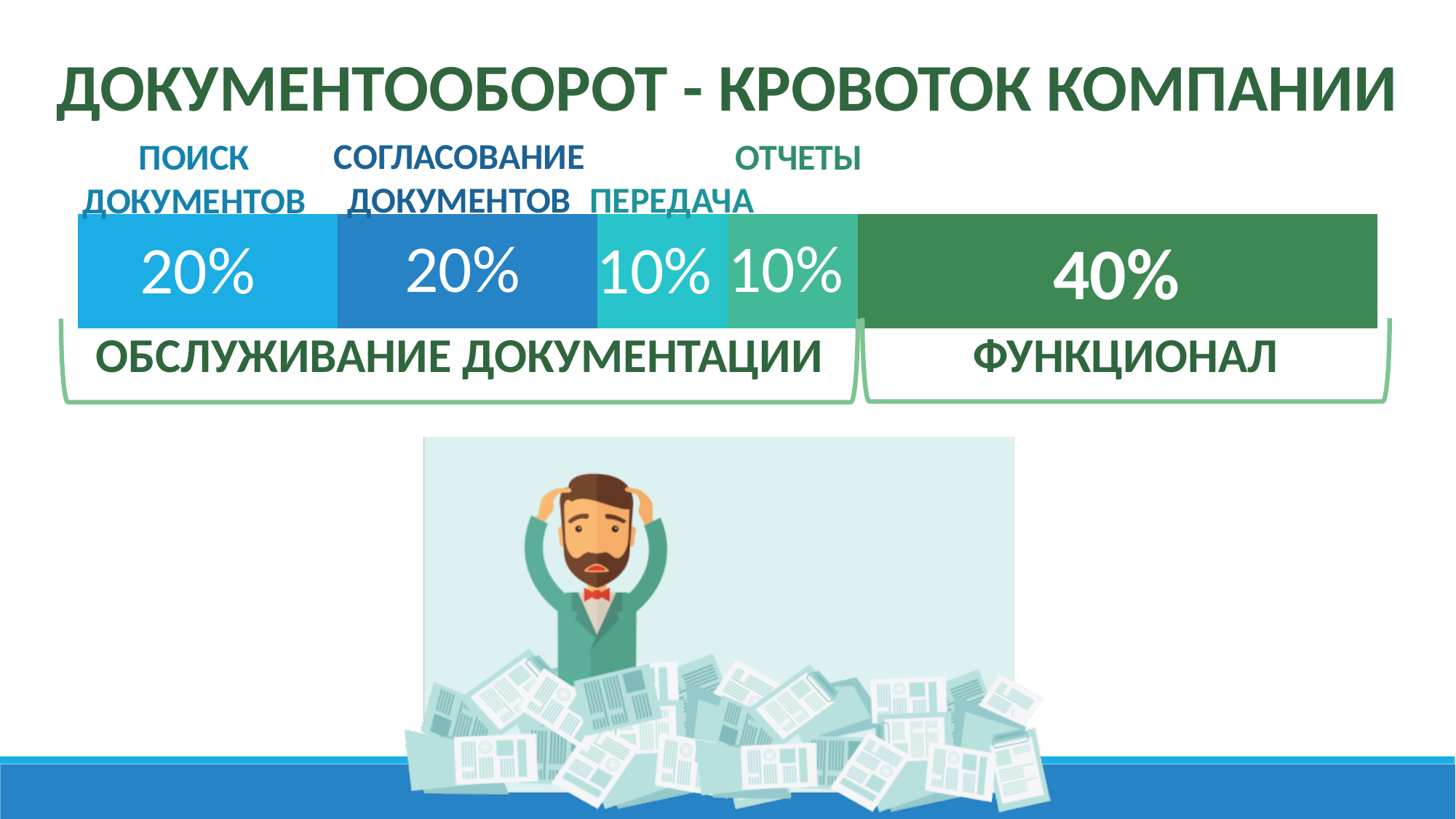
What percentage is shown for the segment labelled ПЕРЕДАЧА? 10% What percentage is shown for the segment labelled ФУНКЦИОНАЛ? 40% What is the title of the slide? ДОКУМЕНТООБОРОТ - КРОВОТОК КОМПАНИИ What is the difference between the ФУНКЦИОНАЛ segment and the ПОИСК ДОКУМЕНТОВ segment? 20% What percentage is shown for the segment labelled ОТЧЕТЫ? 10% How many segments make up the horizontal bar? 5 Which segment of the bar has the largest percentage? ФУНКЦИОНАЛ What percentage is shown for the segment labelled ПОИСК ДОКУМЕНТОВ? 20% What percentage is shown for the segment labelled СОГЛАСОВАНИЕ ДОКУМЕНТОВ? 20% Which is larger, the ПЕРЕДАЧА segment or the СОГЛАСОВАНИЕ ДОКУМЕНТОВ segment? СОГЛАСОВАНИЕ ДОКУМЕНТОВ What kind of chart is shown on the slide? Stacked horizontal bar chart What is the total percentage of the segments grouped under ОБСЛУЖИВАНИЕ ДОКУМЕНТАЦИИ? 60%